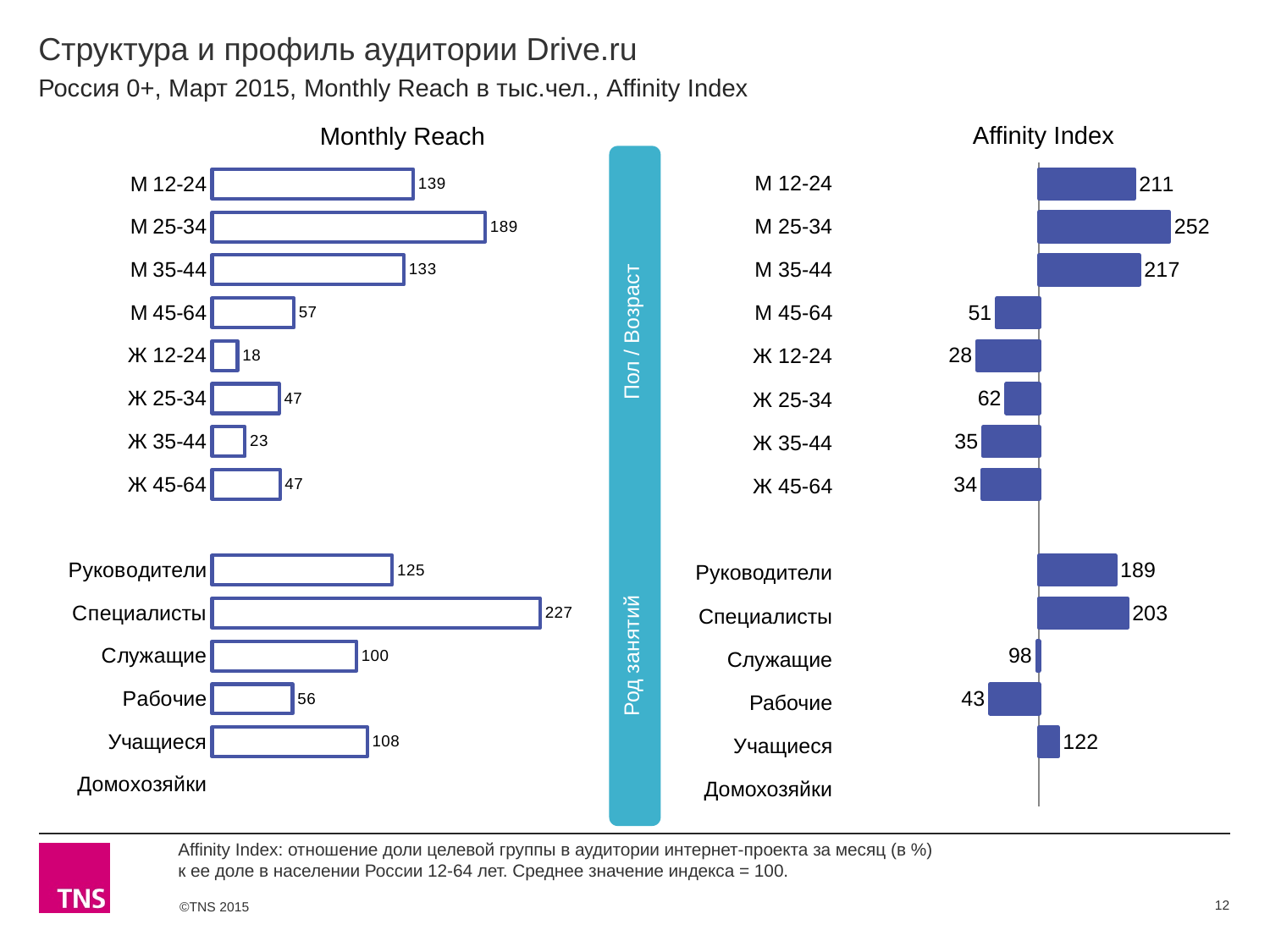
In the Monthly Reach chart, what is the value for М 25-34? 189 In the Monthly Reach chart, which category has the highest value? Специалисты In the Affinity Index chart, what is the difference between the values for Руководители and Рабочие? 146 In the Affinity Index chart, what is the value for Служащие? 98 In the Affinity Index chart, which category has the highest value? М 25-34 In the Monthly Reach chart, what is the difference between the values for М 12-24 and М 35-44? 6 In the Affinity Index chart, which category has the lowest labelled value? Ж 12-24 What kind of chart is the Monthly Reach chart? Bar chart In the Monthly Reach chart, which is larger: the value for Руководители or the value for Учащиеся? Руководители In the Monthly Reach chart, which category has the lowest labelled value? Ж 12-24 In the Affinity Index chart, which is larger: the value for Ж 25-34 or the value for М 45-64? Ж 25-34 In the Affinity Index chart, what is the value for Специалисты? 203